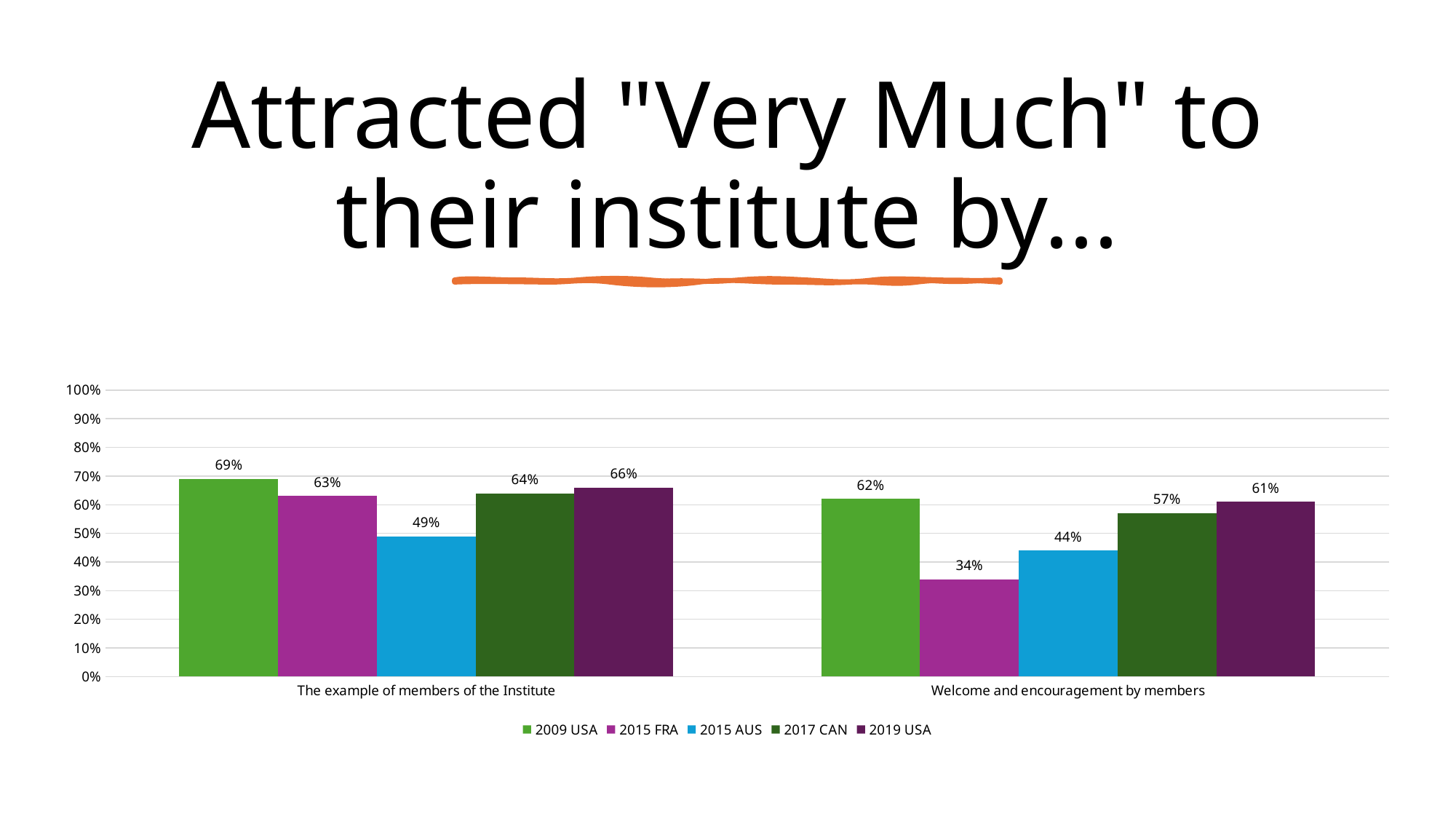
What is the value for 2015 FRA in the category "Welcome and encouragement by members"? 34% How many series does the legend list? 5 Which is larger in the category "The example of members of the Institute": the 2015 FRA value or the 2017 CAN value? 2017 CAN Which series has the highest value in the category "Welcome and encouragement by members"? 2009 USA What kind of chart is shown on the slide? Bar chart How many categories are shown on the x axis? 2 Is the value for 2015 AUS in the category "The example of members of the Institute" greater or less than 50%? less What is the difference between the 2019 USA value and the 2015 AUS value in the category "Welcome and encouragement by members"? 17% Which series has the lowest value in the category "The example of members of the Institute"? 2015 AUS What is the value for 2017 CAN in the category "Welcome and encouragement by members"? 57% What is the value for 2009 USA in the category "The example of members of the Institute"? 69% Which legend entry is shown in blue? 2015 AUS